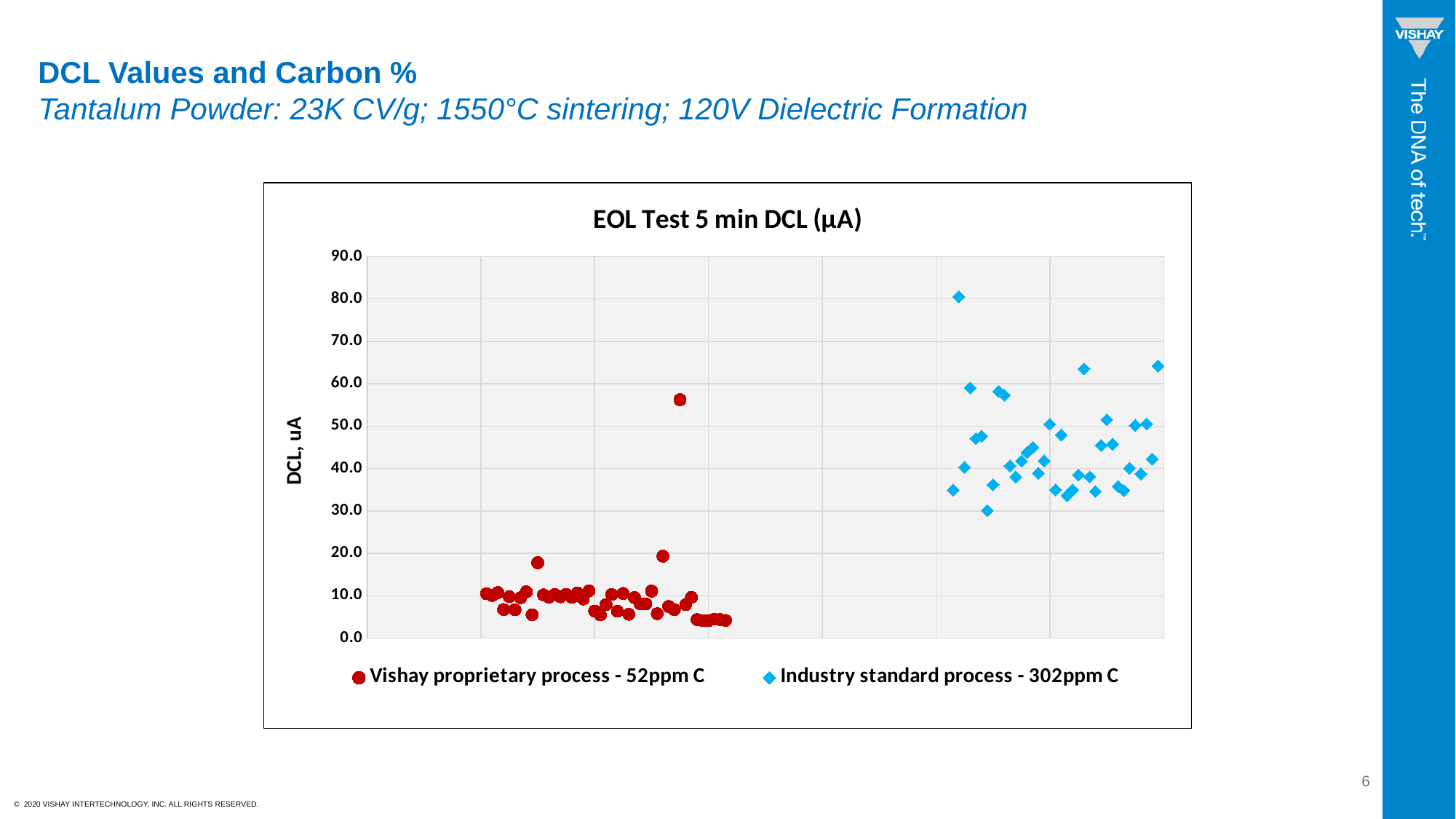
How many series does the legend list? 2 What is the maximum value shown on the vertical axis? 90.0 Is the highest value for the Vishay proprietary process - 52ppm C series greater or less than 60.0? less Which series generally has higher DCL values, Vishay proprietary process - 52ppm C or Industry standard process - 302ppm C? Industry standard process - 302ppm C Is the highest value for the Vishay proprietary process - 52ppm C series greater or less than 50.0? greater What kind of chart is shown on the slide? scatter chart What is the title of the chart? EOL Test 5 min DCL (µA) Is the highest value for the Industry standard process - 302ppm C series greater or less than 70.0? greater Which series has the single highest plotted point on the chart? Industry standard process - 302ppm C What is the label on the vertical axis of the chart? DCL, uA